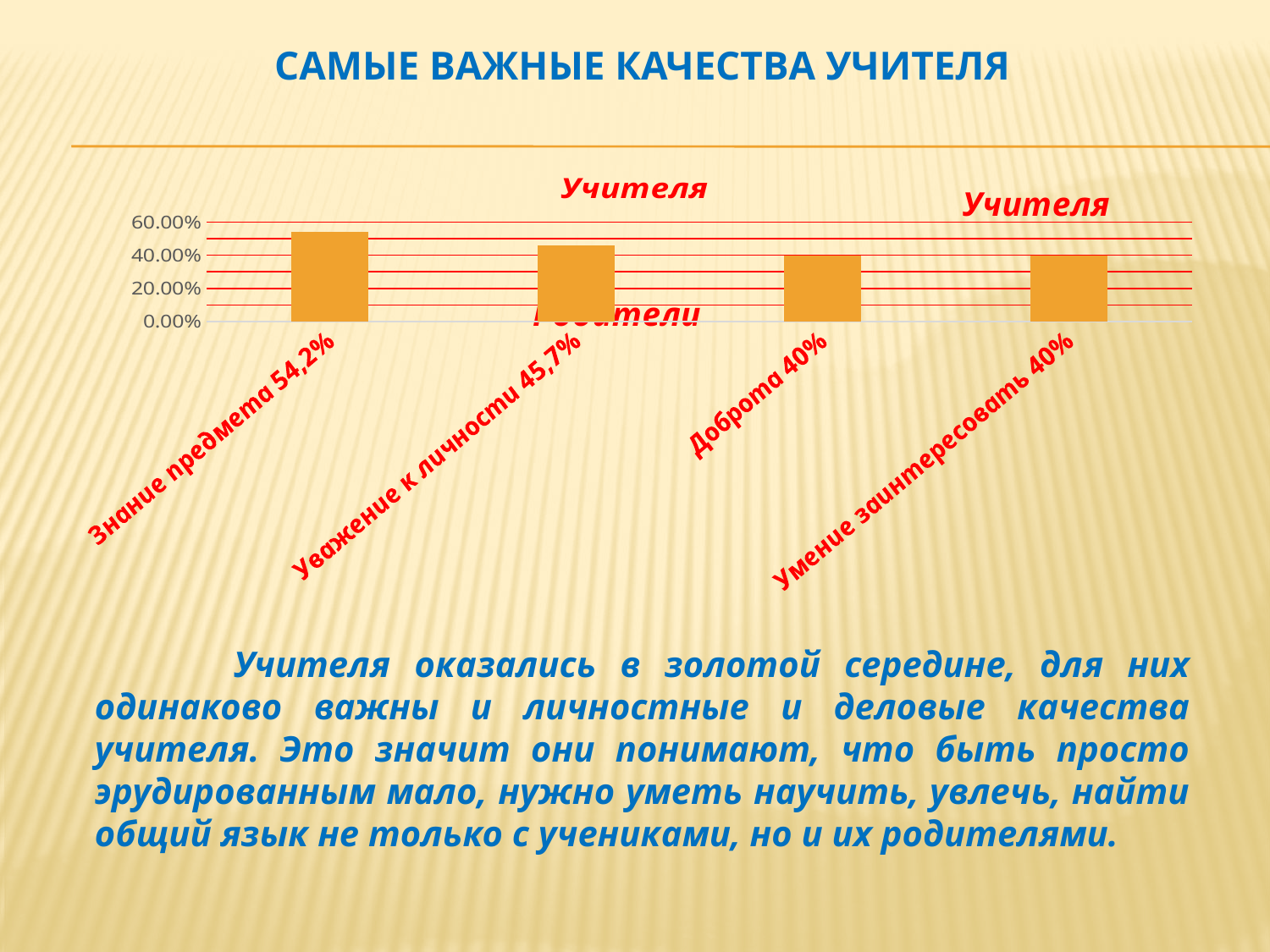
What value is shown for Знание предмета? 54,2% What value is shown for Уважение к личности? 45,7% Which is larger, the value for Знание предмета or the value for Доброта? Знание предмета Is the value for Знание предмета greater or less than 40.00%? greater Is the value for Уважение к личности greater or less than 60.00%? less What is the difference between the values for Знание предмета and Уважение к личности? 8,5% How many bars are plotted in the chart? 4 What value is shown for Умение заинтересовать? 40% What is the title of the slide containing the chart? Самые важные качества учителя What kind of chart is shown on the slide? Bar chart Which category has the highest value? Знание предмета What value is shown for Доброта? 40%